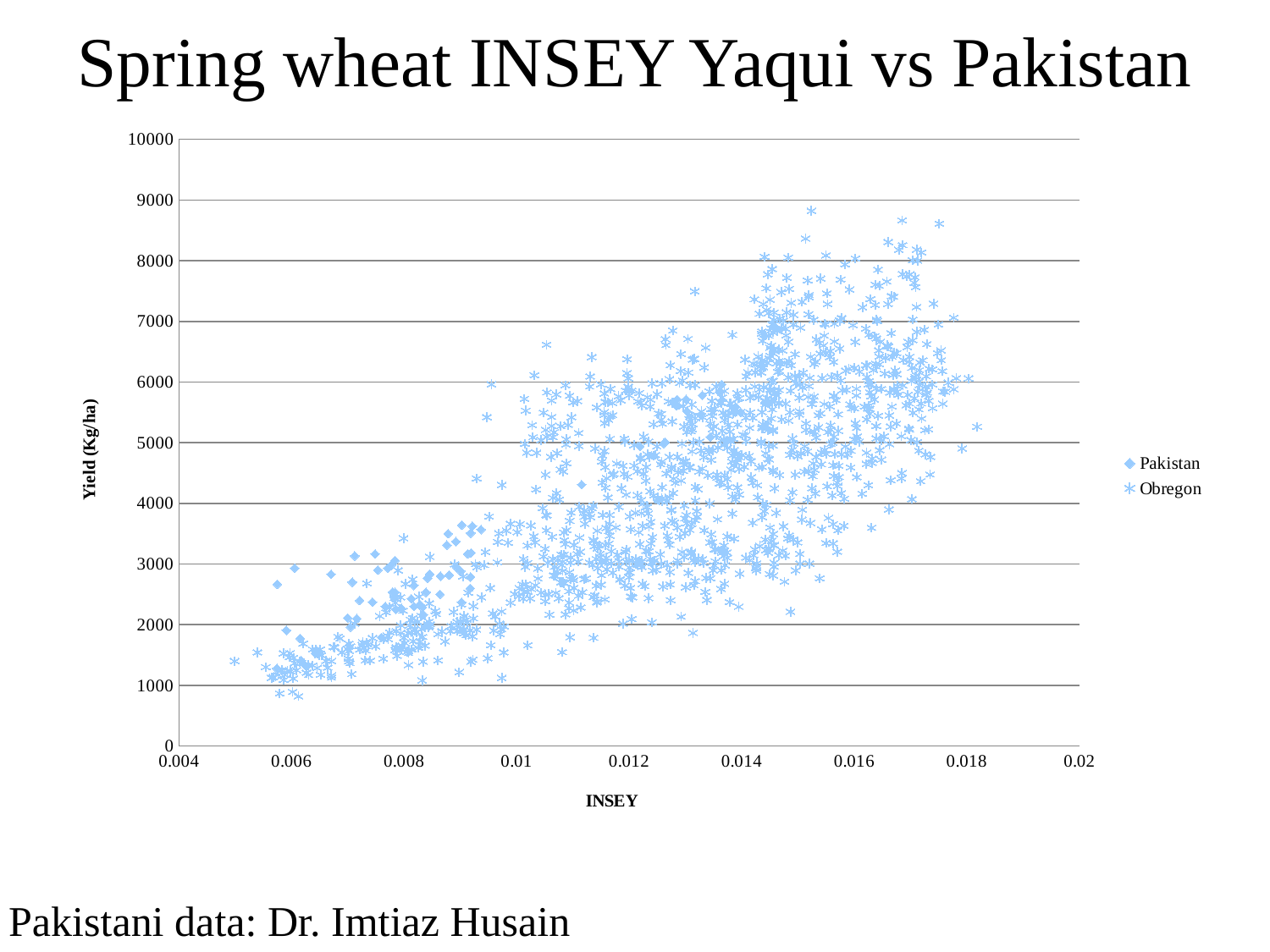
Which series reaches higher yield values, Pakistan or Obregon? Obregon What is the title of the chart? Spring wheat INSEY Yaqui vs Pakistan What is the maximum value shown on the y axis? 10000 Which two series are listed in the legend? Pakistan and Obregon Is the highest Obregon yield value greater or less than 8000? greater Is the highest Pakistan yield value greater or less than 7000? less Is the lowest Obregon yield value greater or less than 1000? less As INSEY increases along the x axis, does yield generally rise or fall? rise What kind of chart is shown on the slide? scatter plot How many series does the legend list? 2 What is the label of the y axis? Yield (Kg/ha)